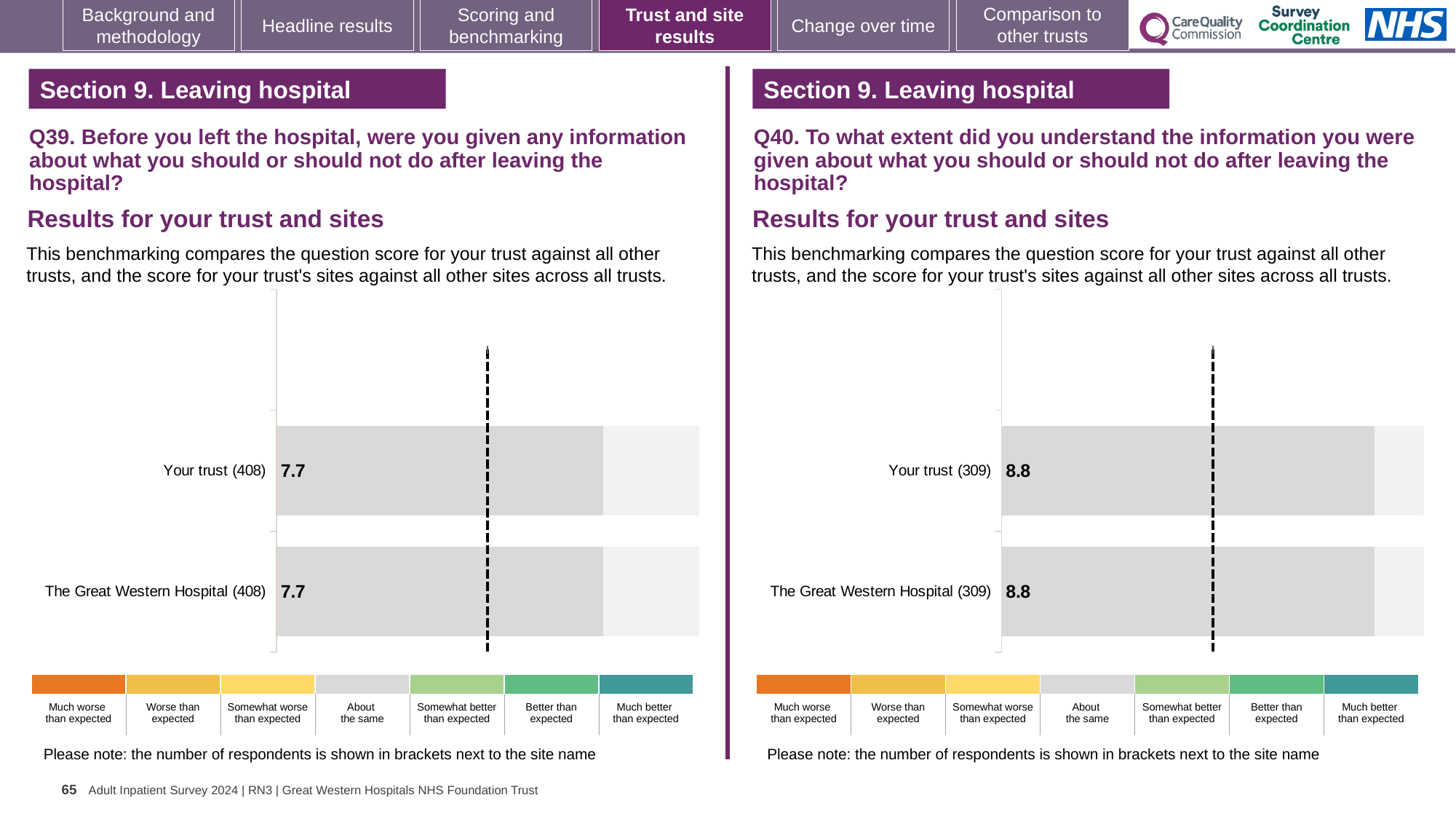
How many bars are plotted on the Q39 chart (left)? 2 On the Q39 chart (left), what is the score for Your trust? 7.7 On the Q40 chart (right), what is the score for The Great Western Hospital? 8.8 On the Q40 chart (right), what is the score for Your trust? 8.8 On the Q39 chart (left), what is the score for The Great Western Hospital? 7.7 What kind of chart is used on the Q40 chart (right)? bar chart On the Q39 chart (left), how many respondents are shown in brackets for Your trust? 408 On the Q40 chart (right), how many respondents are shown in brackets for The Great Western Hospital? 309 How many categories does the colour key below the Q40 chart (right) list? 7 On the Q39 chart (left), which category does the colour key label with the orange colour at the far left? Much worse than expected Is the score for Your trust on the Q40 chart (right) larger or smaller than the score for Your trust on the Q39 chart (left)? larger On the Q39 chart (left), what is the difference between the score for Your trust and the score for The Great Western Hospital? 0